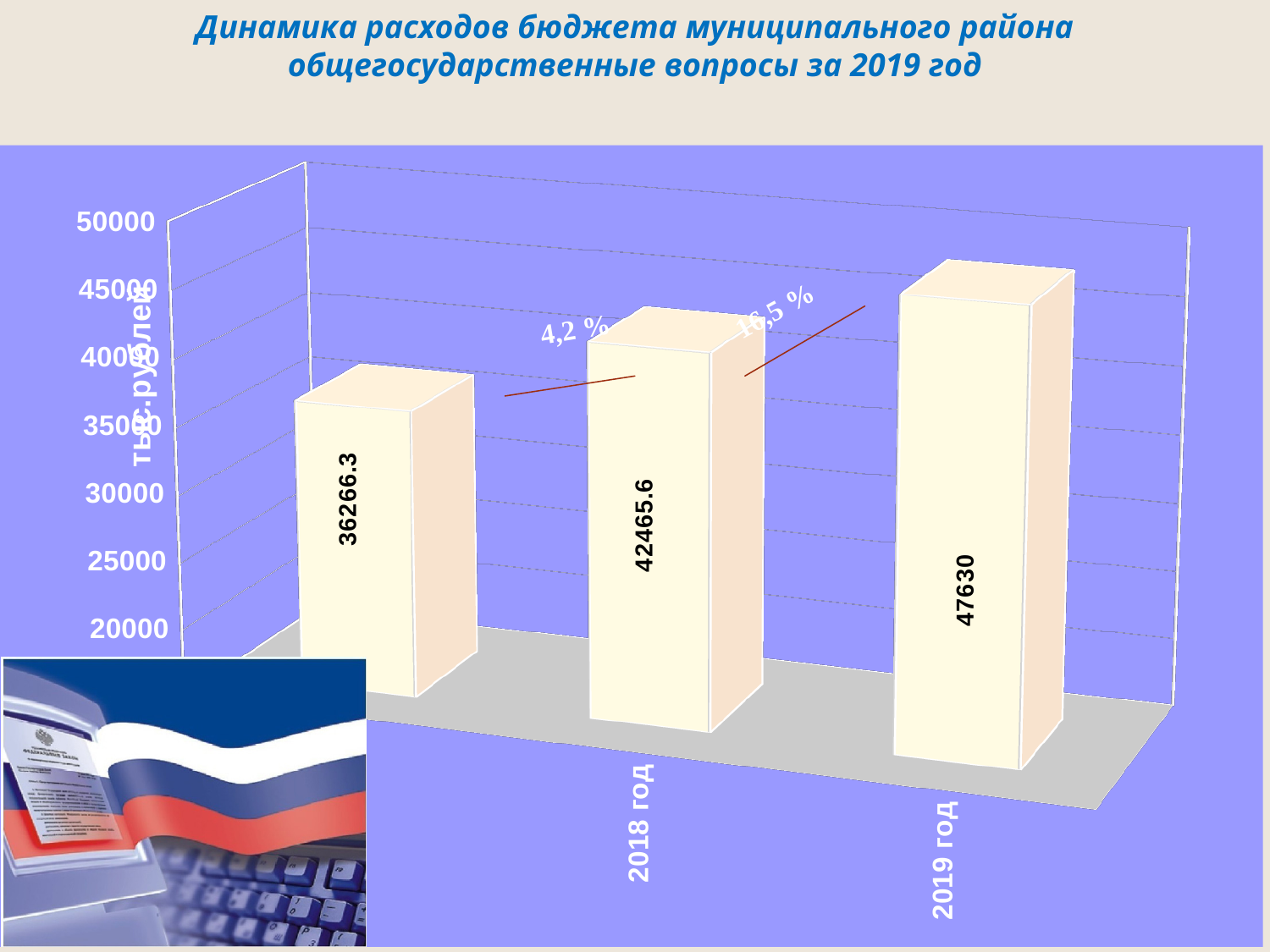
What is the difference between the values for 2019 год and 2018 год? 5164.4 What is the value for 2018 год? 42465.6 What type of chart is shown on the slide? bar chart What unit is shown on the vertical axis label? тыс.рублей How many bars are plotted in the chart? 3 Which is larger, the value for 2018 год or the value for 2019 год? 2019 год What percentage change is annotated between the 2018 год and 2019 год bars? 16,5 % What is the value for 2019 год? 47630 Do the values rise or fall from left to right along the x axis? rise Which year has the highest value, 2018 год or 2019 год? 2019 год Is the value for 2019 год greater or less than 45000? greater Is the value for 2018 год greater or less than 40000? greater